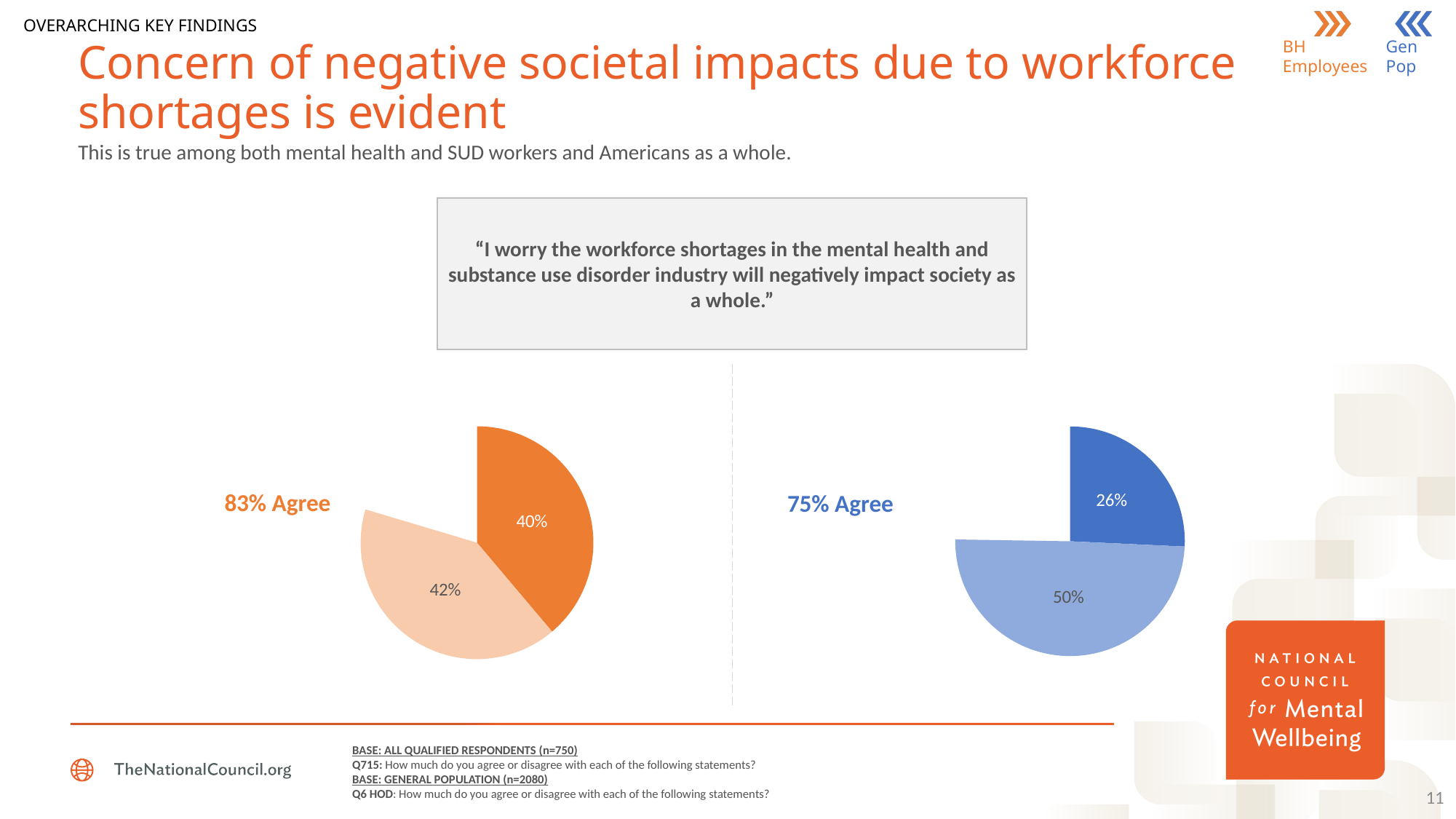
What is the difference between the overall agreement shown for the left (orange) pie chart and the right (blue) pie chart? 8 percentage points In the right (blue) pie chart, what value is shown on the dark blue slice? 26% In the right (blue) pie chart, what is the difference between the light blue slice and the dark blue slice? 24 percentage points In the right (blue) pie chart, which slice is larger, the dark blue or the light blue? Light blue In the left (orange) pie chart, what value is shown on the light orange slice? 42% What kind of chart is used on the left side of the slide? Pie chart What total agreement percentage is printed next to the right (blue) pie chart? 75% Agree What total agreement percentage is printed next to the left (orange) pie chart? 83% Agree In the left (orange) pie chart, what value is shown on the dark orange slice? 40% How many labelled slices does the left (orange) pie chart have? 2 Which pie chart shows the higher overall agreement, the left (orange) one or the right (blue) one? The left (orange) one In the right (blue) pie chart, what value is shown on the light blue slice? 50%